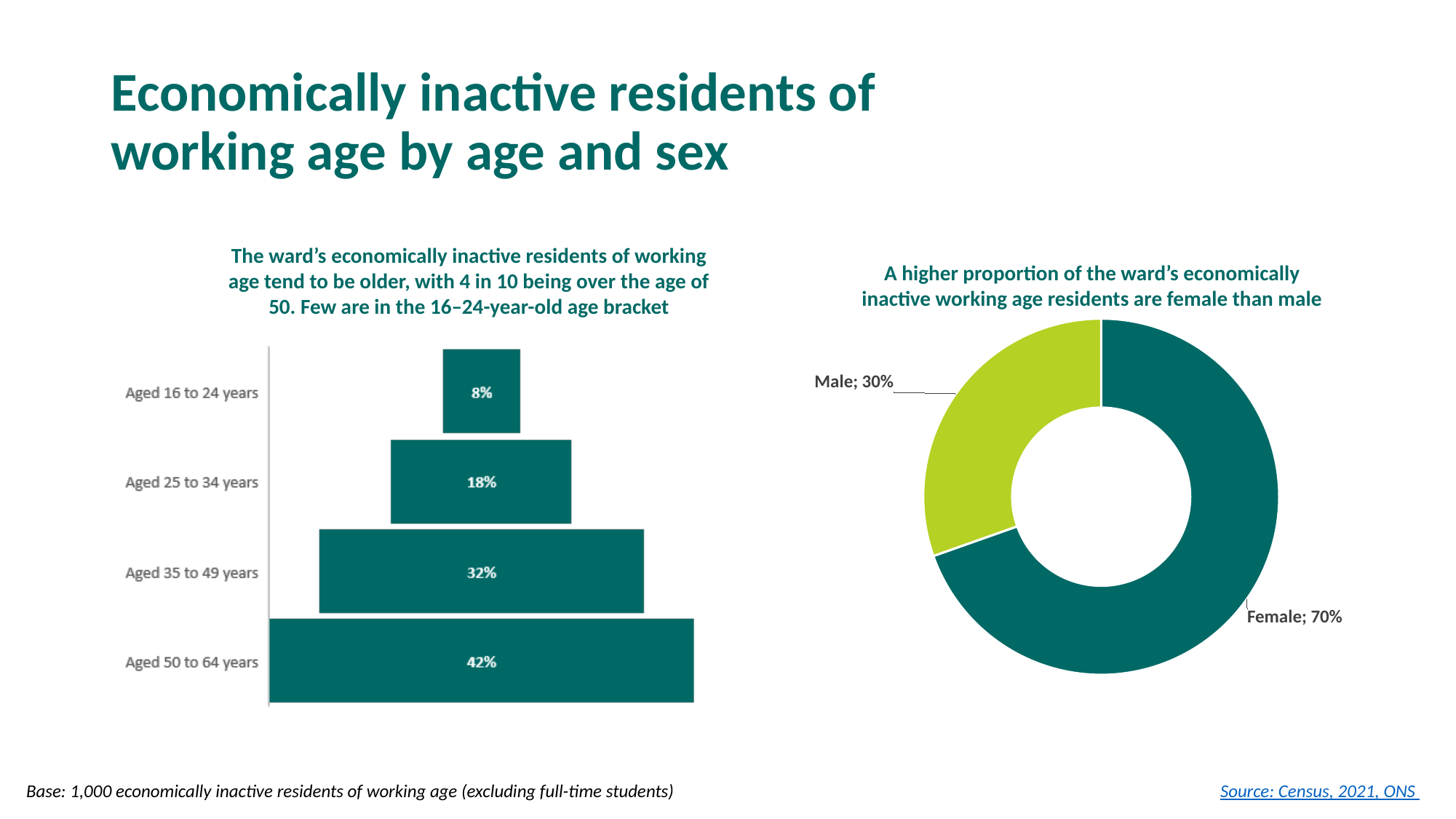
In the left chart (age bands), which age group has the highest value? Aged 50 to 64 years In the right chart (by sex), what share is Female? 70% In the left chart (age bands), what is the value for Aged 16 to 24 years? 8% In the left chart (age bands), which is larger: the value for Aged 25 to 34 years or Aged 35 to 49 years? Aged 35 to 49 years In the left chart (age bands), what is the value for Aged 35 to 49 years? 32% In the left chart (age bands), what is the difference between the values for Aged 50 to 64 years and Aged 25 to 34 years? 24% What kind of chart is the left chart showing age bands? Bar chart In the right chart (by sex), what is the difference between the Female and Male shares? 40% What kind of chart is the right chart showing residents by sex? Doughnut chart In the right chart (by sex), what is the value for Male? 30% In the left chart (age bands), which age group has the lowest value? Aged 16 to 24 years How many age groups are shown in the left chart? 4